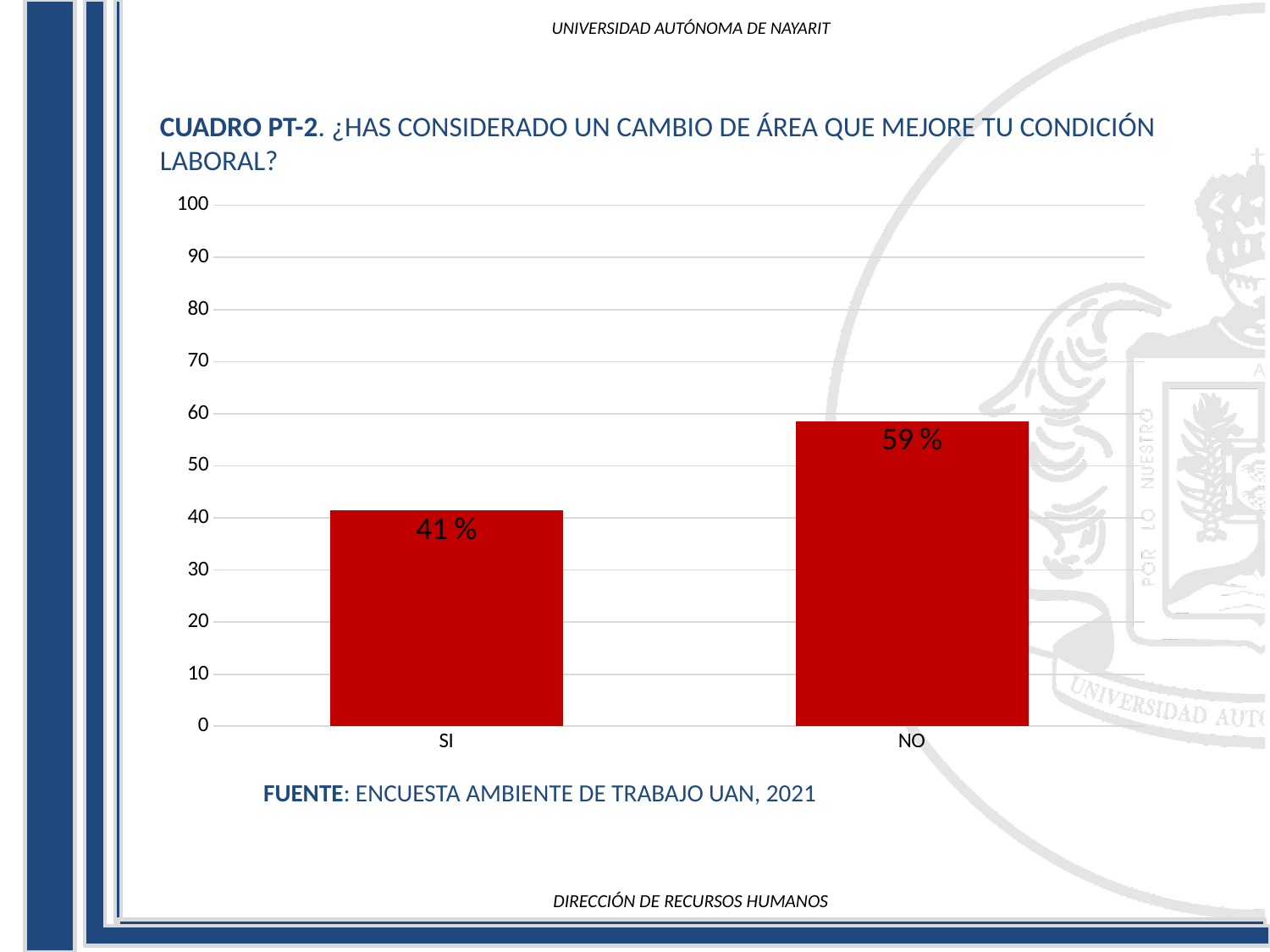
What kind of chart is shown on the slide? bar chart What colour are the bars in the chart? red What is the value for SI? 41 % Which is larger, the value for SI or the value for NO? NO What is the maximum value shown on the y axis? 100 How many categories are shown on the x axis? 2 What is the difference between the values for NO and SI? 18 % Which category has the highest value? NO Which category has the lowest value? SI Is the value for NO greater or less than 50? greater Is the value for SI greater or less than 50? less What is the value for NO? 59 %